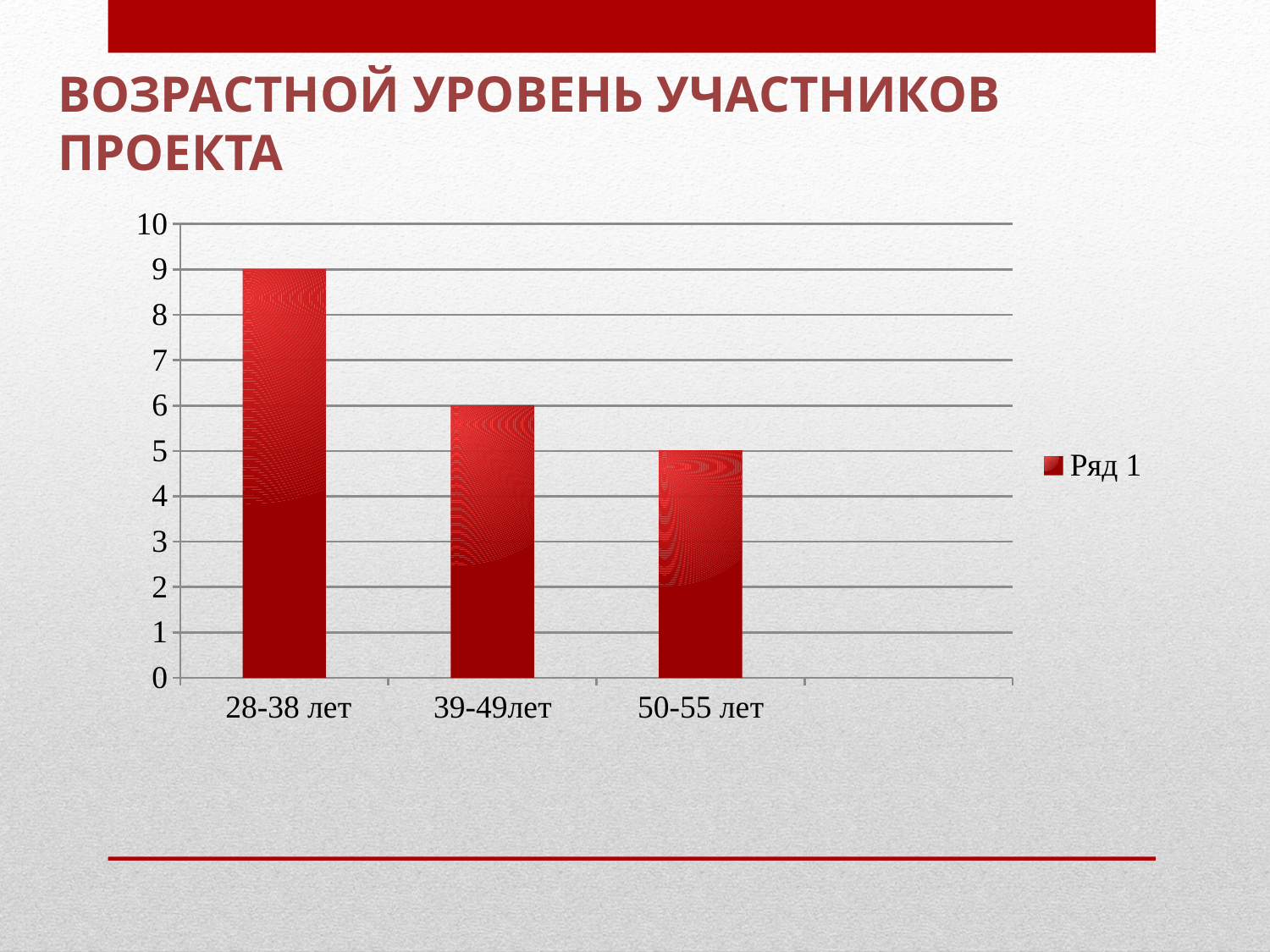
Which age category has the highest value? 28-38 лет Do the values rise or fall from left to right along the x axis? Fall What is the difference between the values for 28-38 лет and 39-49лет? 3 What kind of chart is shown on the slide? Bar chart How many age categories are shown on the chart? 3 Which is larger, the value for 39-49лет or the value for 50-55 лет? 39-49лет How many series does the legend list? 1 Which age category has the lowest value? 50-55 лет What is the value for the 28-38 лет category? 9 What is the value for the 50-55 лет category? 5 What is the value for the 39-49лет category? 6 What is the difference between the values for 28-38 лет and 50-55 лет? 4